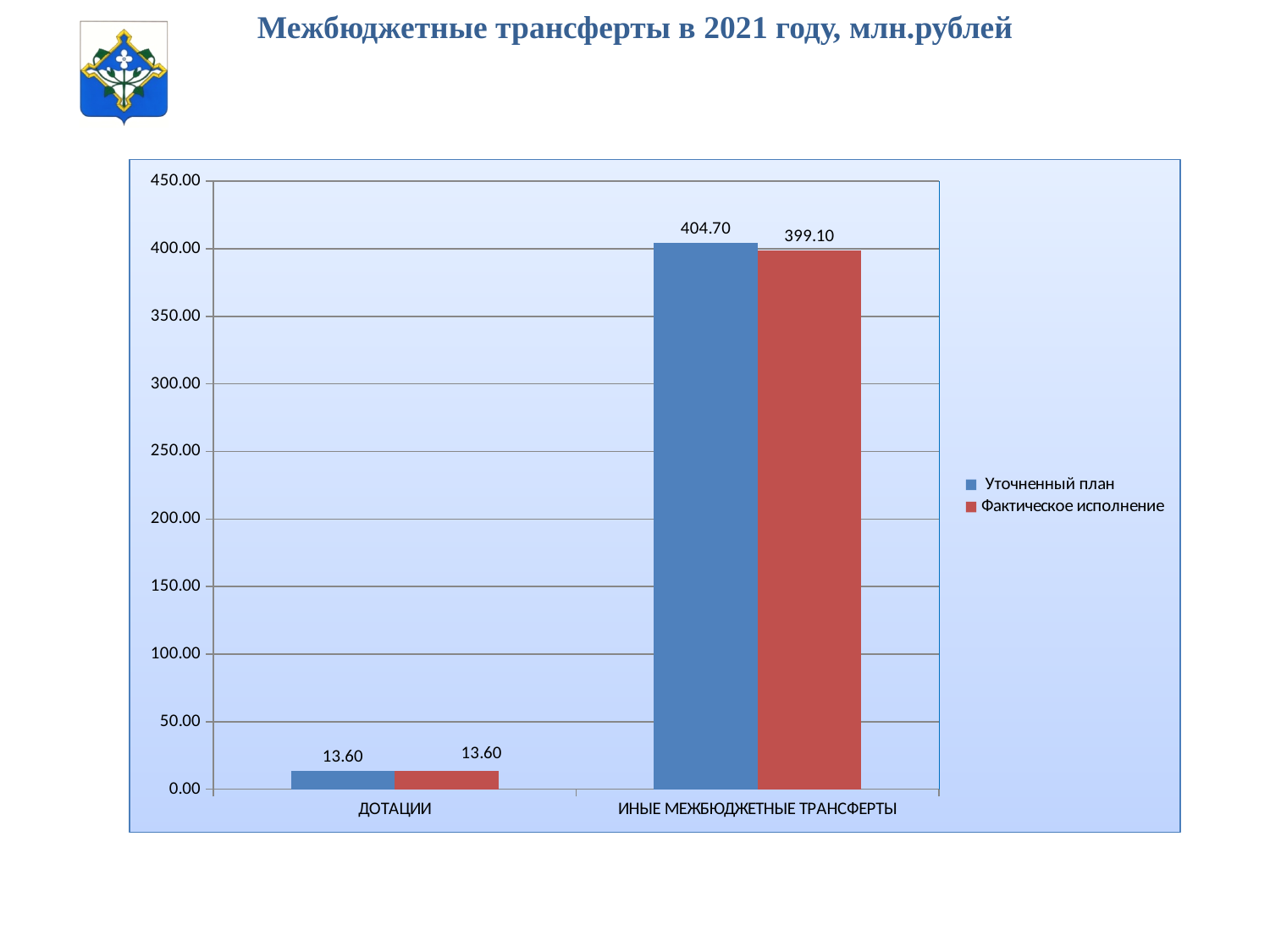
Which category has the lowest Фактическое исполнение value? ДОТАЦИИ Which category has the highest Уточненный план value? ИНЫЕ МЕЖБЮДЖЕТНЫЕ ТРАНСФЕРТЫ Is the Уточненный план value for ИНЫЕ МЕЖБЮДЖЕТНЫЕ ТРАНСФЕРТЫ greater or less than 400.00? greater How many categories are shown on the x axis? 2 What kind of chart is shown on the slide? bar chart What is the value of Уточненный план for ДОТАЦИИ? 13.60 For ИНЫЕ МЕЖБЮДЖЕТНЫЕ ТРАНСФЕРТЫ, which is larger: Уточненный план or Фактическое исполнение? Уточненный план What is the value of Фактическое исполнение for ИНЫЕ МЕЖБЮДЖЕТНЫЕ ТРАНСФЕРТЫ? 399.10 What is the title of the slide? Межбюджетные трансферты в 2021 году, млн.рублей How many series does the legend list? 2 What is the difference between Уточненный план and Фактическое исполнение for ИНЫЕ МЕЖБЮДЖЕТНЫЕ ТРАНСФЕРТЫ? 5.60 What is the value of Уточненный план for ИНЫЕ МЕЖБЮДЖЕТНЫЕ ТРАНСФЕРТЫ? 404.70